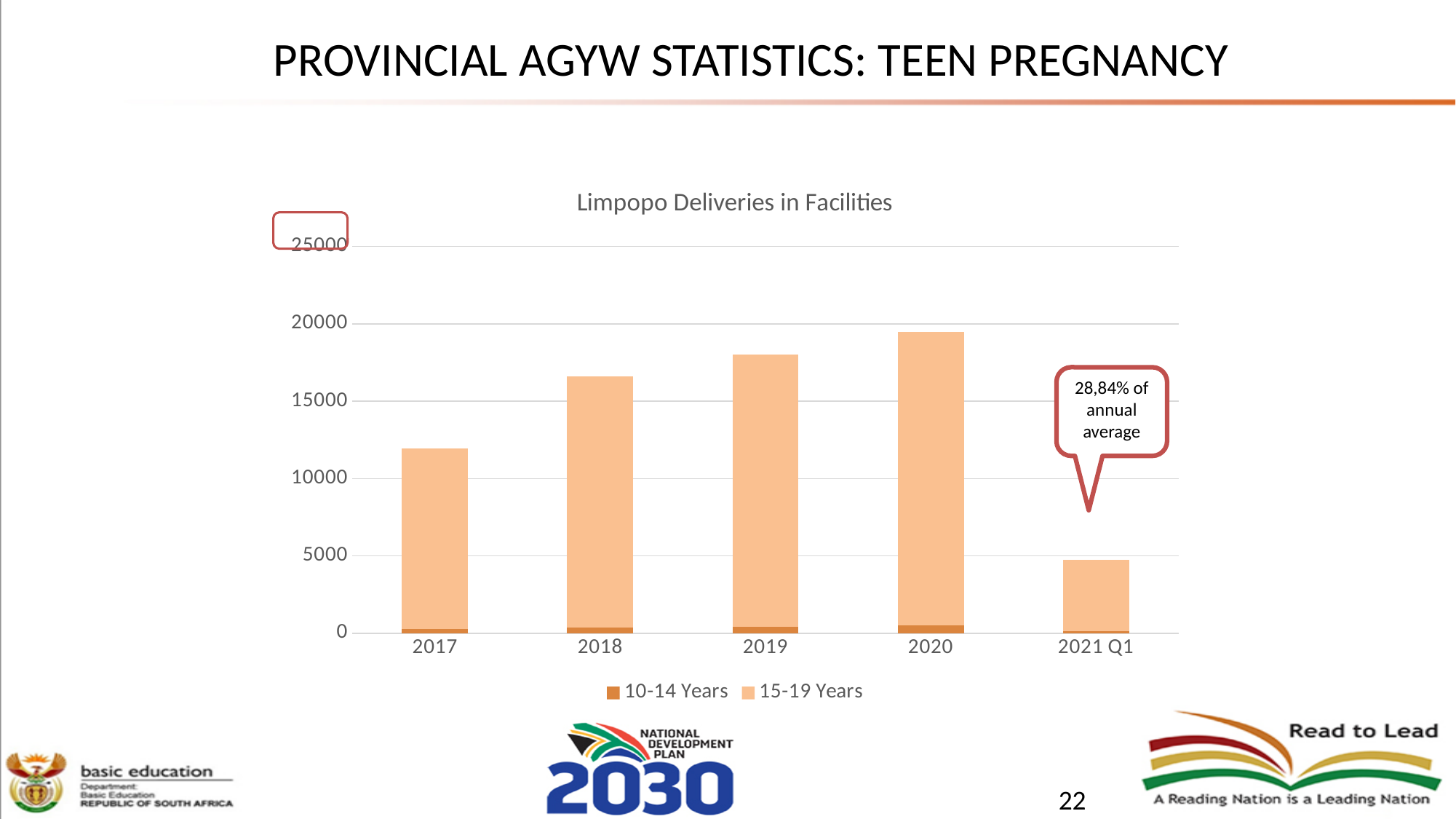
Which year has the tallest bar? 2020 How many categories are shown on the x axis? 5 Is the total bar for 2017 greater or less than 10000? greater Which bar is taller, 2019 or 2017? 2019 What kind of chart is shown on the slide? Bar chart What is the title of the chart? Limpopo Deliveries in Facilities Which category has the shortest bar? 2021 Q1 Do the bars rise or fall from 2017 to 2020? Rise Is the total bar for 2018 greater or less than 15000? greater Is the total bar for 2021 Q1 greater or less than 10000? less How many series does the legend list? 2